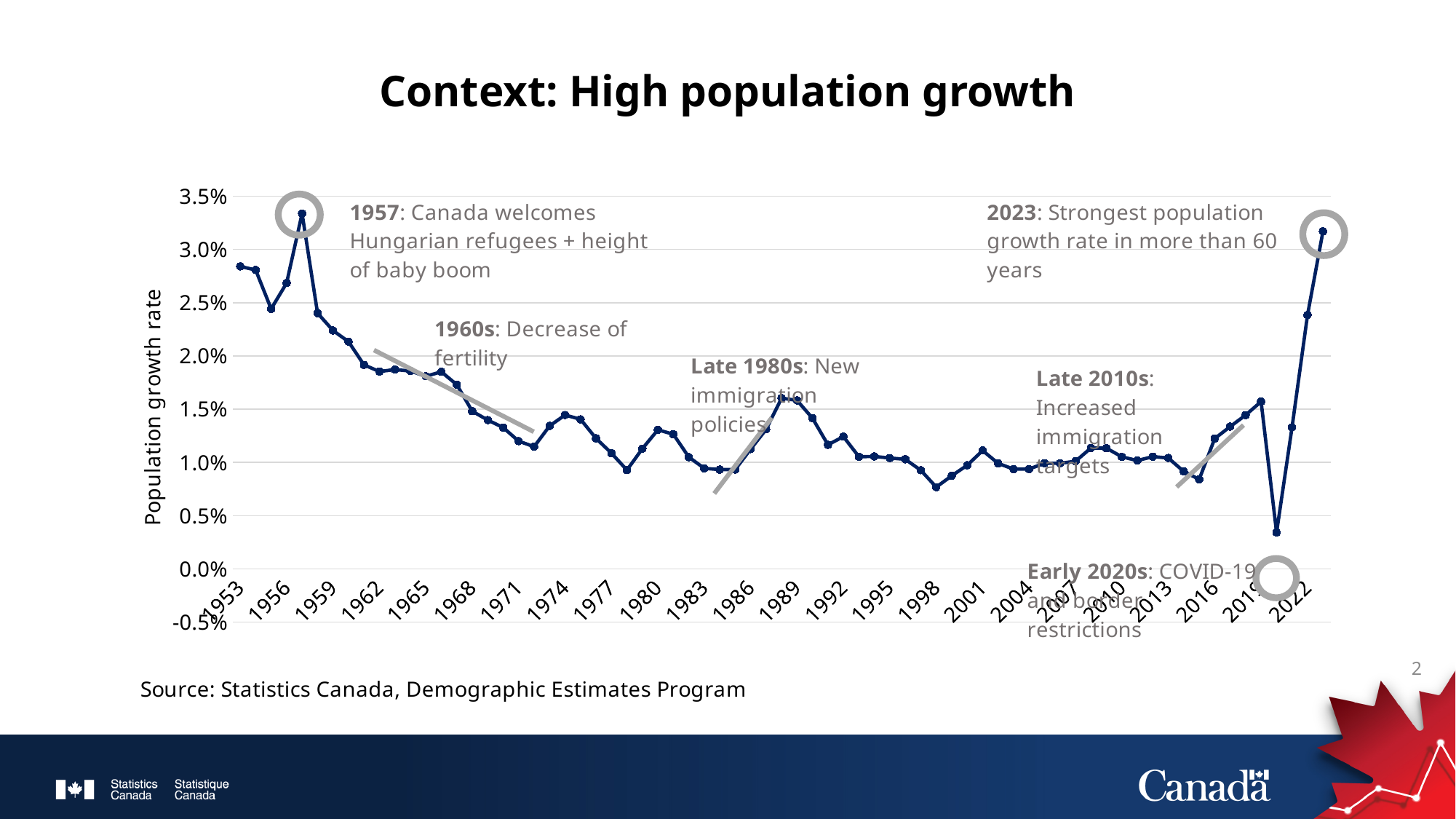
Which year has the higher population growth rate, 1957 or 2020? 1957 What is the label of the vertical axis? Population growth rate Is the population growth rate for 1957 greater or less than 3.0%? greater What kind of chart is shown on the slide? line chart Is the population growth rate for 2020 greater or less than 0.5%? less Does the population growth rate rise or fall between 1959 and 1971? fall Is the population growth rate for 1953 greater or less than 2.5%? greater According to the annotation on the chart, what happened in 1957? Canada welcomes Hungarian refugees + height of baby boom In which year is the population growth rate lowest? 2020 Does the population growth rate rise or fall between 2020 and 2023? rise